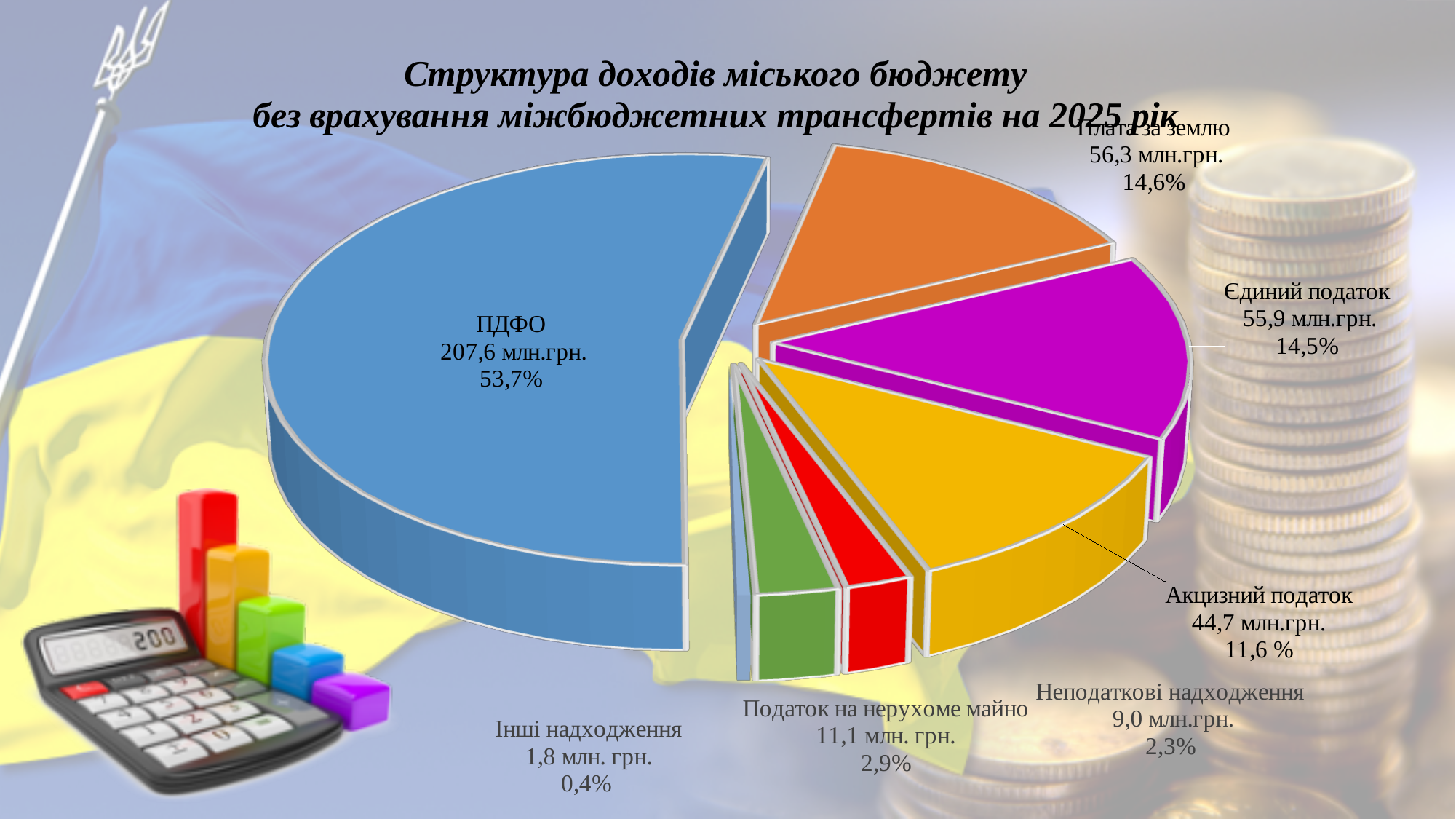
Which is larger, Єдиний податок or Акцизний податок? Єдиний податок How many categories are shown in the pie chart? 7 What share of the pie does ПДФО represent? 53,7% Which category has the largest slice of the pie? ПДФО What is the difference between the values for Плата за землю and Єдиний податок? 0,4 млн.грн. What share of the pie does Плата за землю represent? 14,6% Which category has the smallest slice of the pie? Інші надходження What colour is the ПДФО slice? Blue What is the value for ПДФО in the pie chart? 207,6 млн.грн. What kind of chart is shown on the slide? Pie chart What is the value for Неподаткові надходження? 9,0 млн.грн. What is the value for Акцизний податок? 44,7 млн.грн.